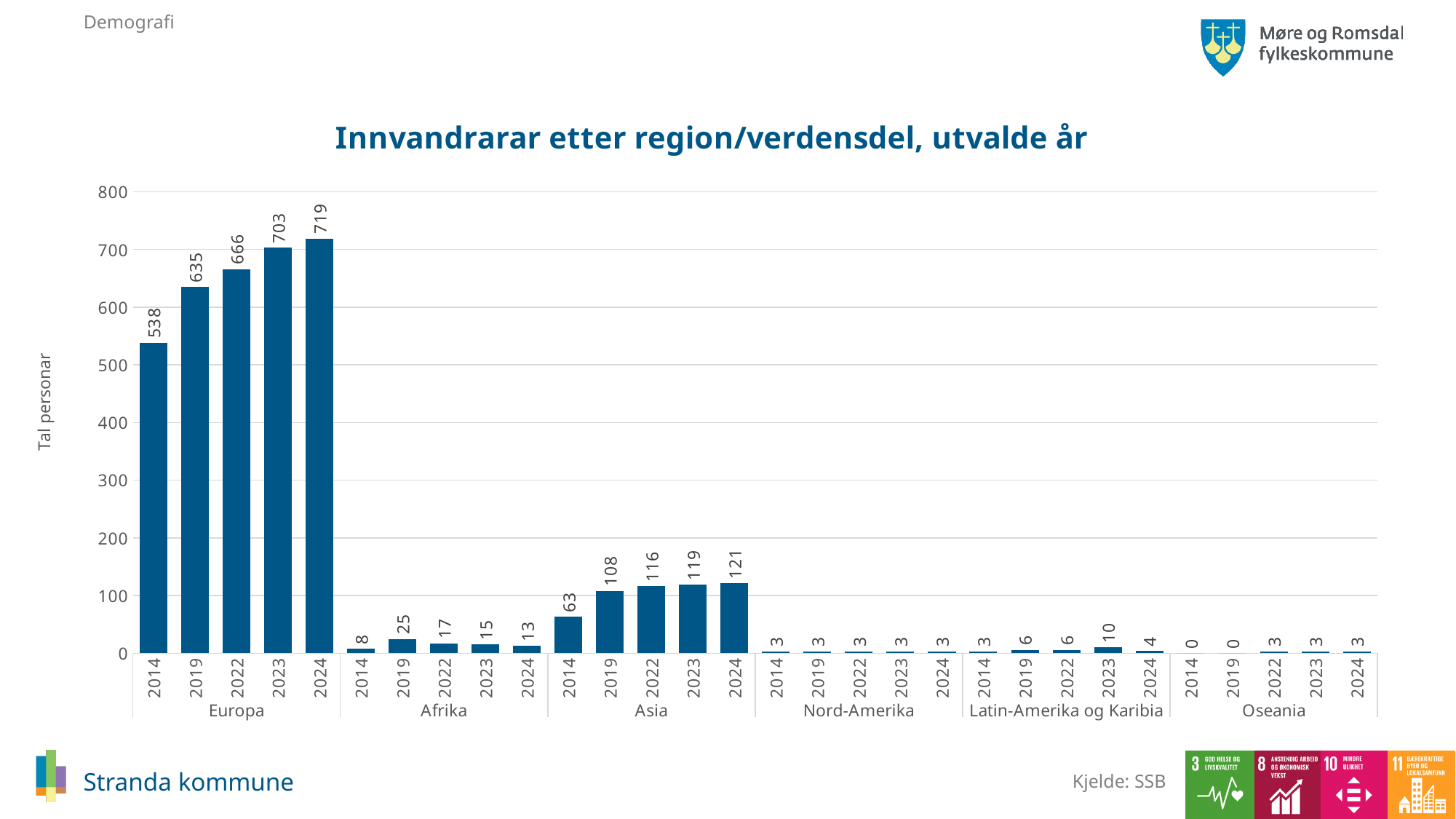
Do the values for Asia rise or fall from 2014 to 2024? rise Which year has the lowest value for Europa? 2014 Is the value for Europa in 2022 greater or less than 600? greater What is the title of the chart? Innvandrarar etter region/verdensdel, utvalde år What is the value for Europa in 2024? 719 What is the difference between the Europa values for 2024 and 2014? 181 Which region has the highest bar in 2024? Europa What kind of chart is shown? bar chart What is the value for Afrika in 2014? 8 How many regions are shown on the x axis? 6 What is the value for Asia in 2019? 108 Which is larger, the value for Afrika in 2019 or the value for Asia in 2014? Asia in 2014